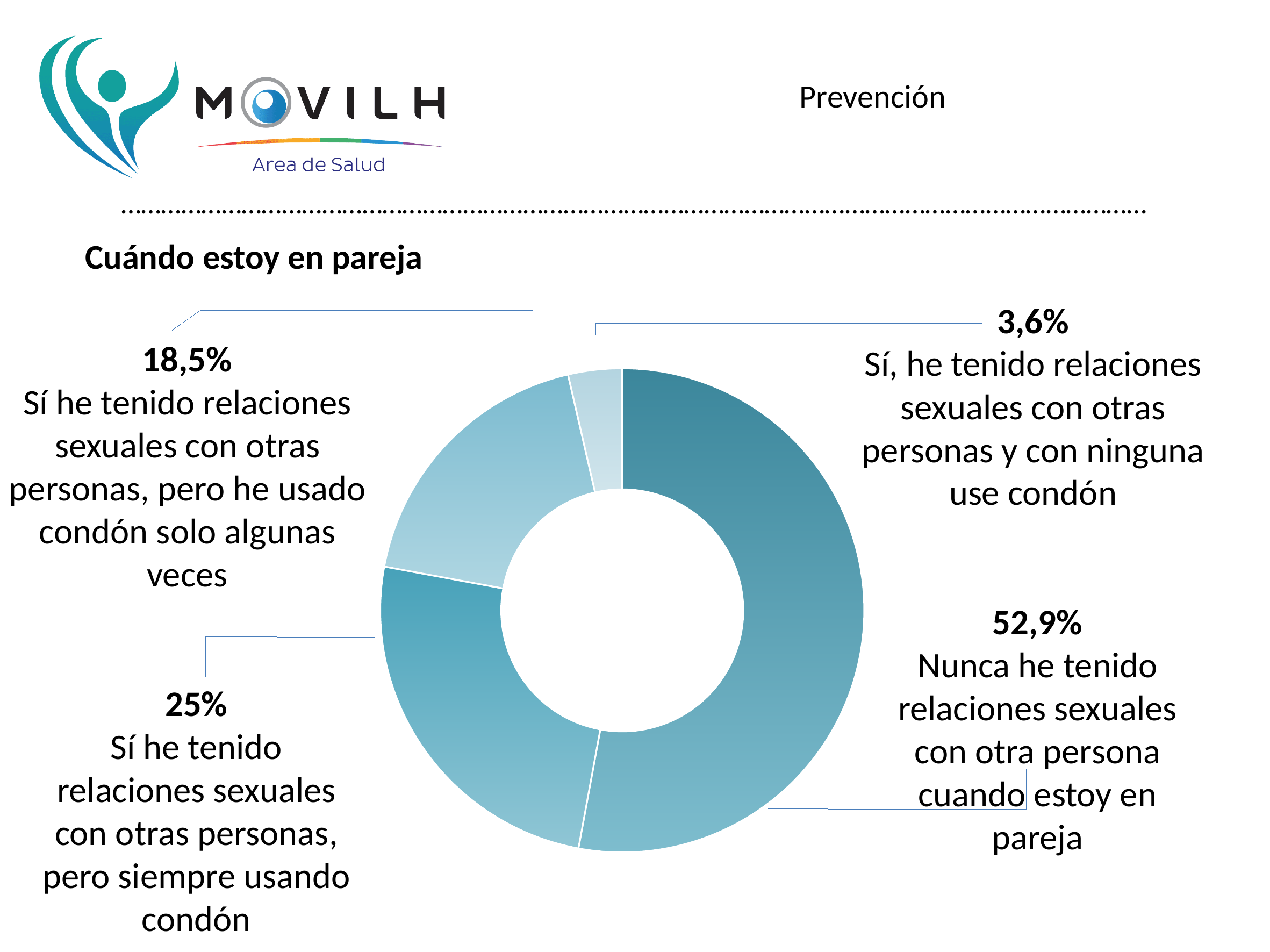
How many categories does the chart show? 4 What kind of chart is shown on the slide? Doughnut chart Which category has the largest share of the chart? Nunca he tenido relaciones sexuales con otra persona cuando estoy en pareja What percentage of respondents answered "Sí he tenido relaciones sexuales con otras personas, pero he usado condón solo algunas veces"? 18,5% What is the title of the chart? Cuándo estoy en pareja What is the difference in percentage points between the largest share (52,9%) and the smallest share (3,6%)? 49,3 Which category has the smallest share of the chart? Sí, he tenido relaciones sexuales con otras personas y con ninguna use condón What percentage of respondents answered "Sí, he tenido relaciones sexuales con otras personas y con ninguna use condón"? 3,6% What is the difference in percentage points between "siempre usando condón" (25%) and "condón solo algunas veces" (18,5%)? 6,5 Which is larger: the share for "siempre usando condón" or the share for "condón solo algunas veces"? siempre usando condón What percentage of respondents answered "Nunca he tenido relaciones sexuales con otra persona cuando estoy en pareja"? 52,9% What percentage of respondents answered "Sí he tenido relaciones sexuales con otras personas, pero siempre usando condón"? 25%